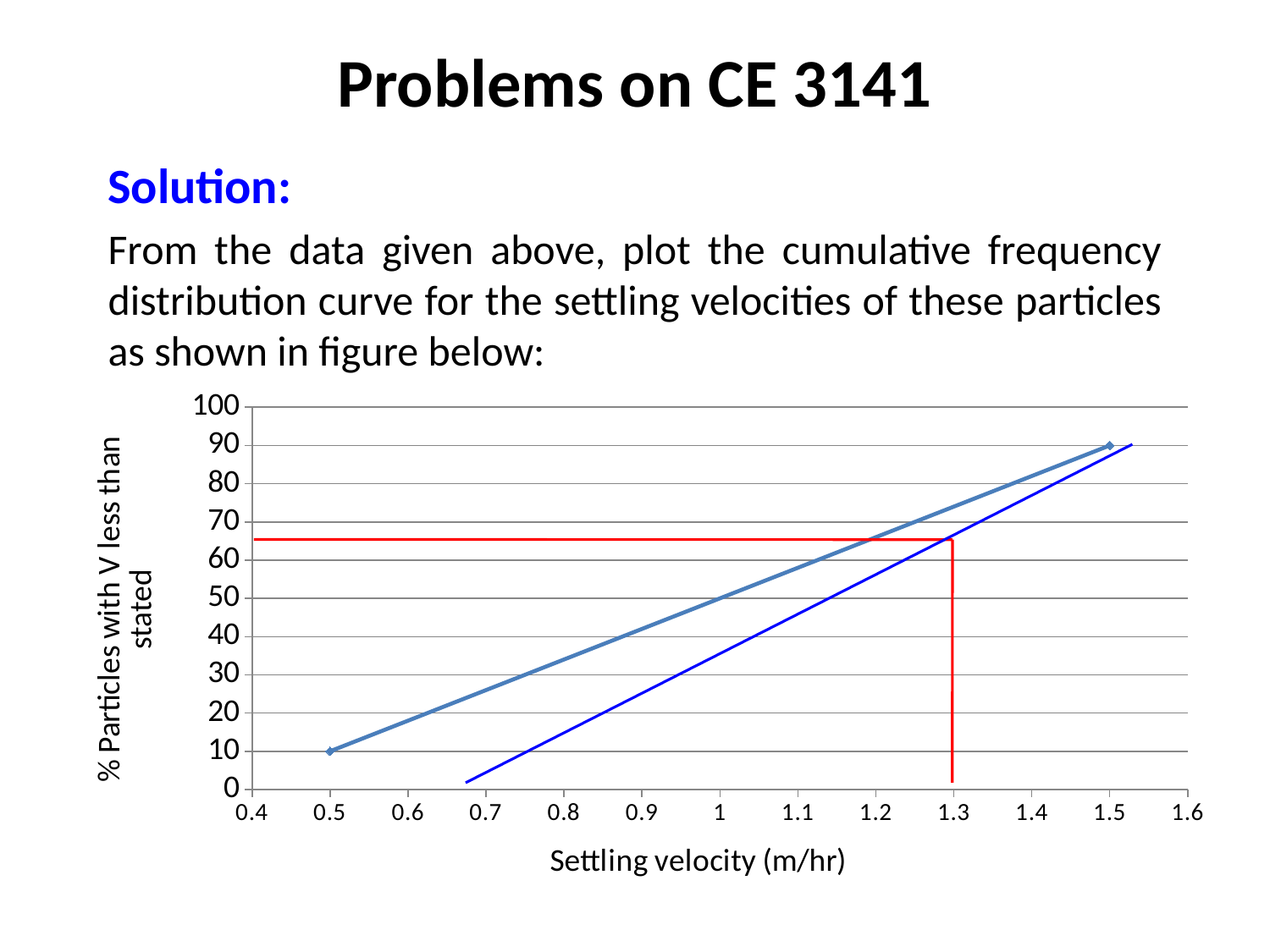
What is the title of the x axis? Settling velocity (m/hr) What is the % of particles with V less than stated at a settling velocity of 0.5 m/hr? 10 What kind of chart is shown on the slide? line chart What is the % of particles with V less than stated at a settling velocity of 1.5 m/hr? 90 How many marked data points are plotted on the line? 2 What is the highest value shown on the x axis? 1.6 Does the plotted line rise or fall as settling velocity increases? rises Is the plotted value at a settling velocity of 1.0 m/hr greater or less than 40? greater What is the difference between the plotted values at settling velocities of 1.5 m/hr and 0.5 m/hr? 80 Is the plotted value at a settling velocity of 1.3 m/hr greater or less than 60? greater Which settling velocity has the higher plotted value, 0.5 m/hr or 1.5 m/hr? 1.5 m/hr